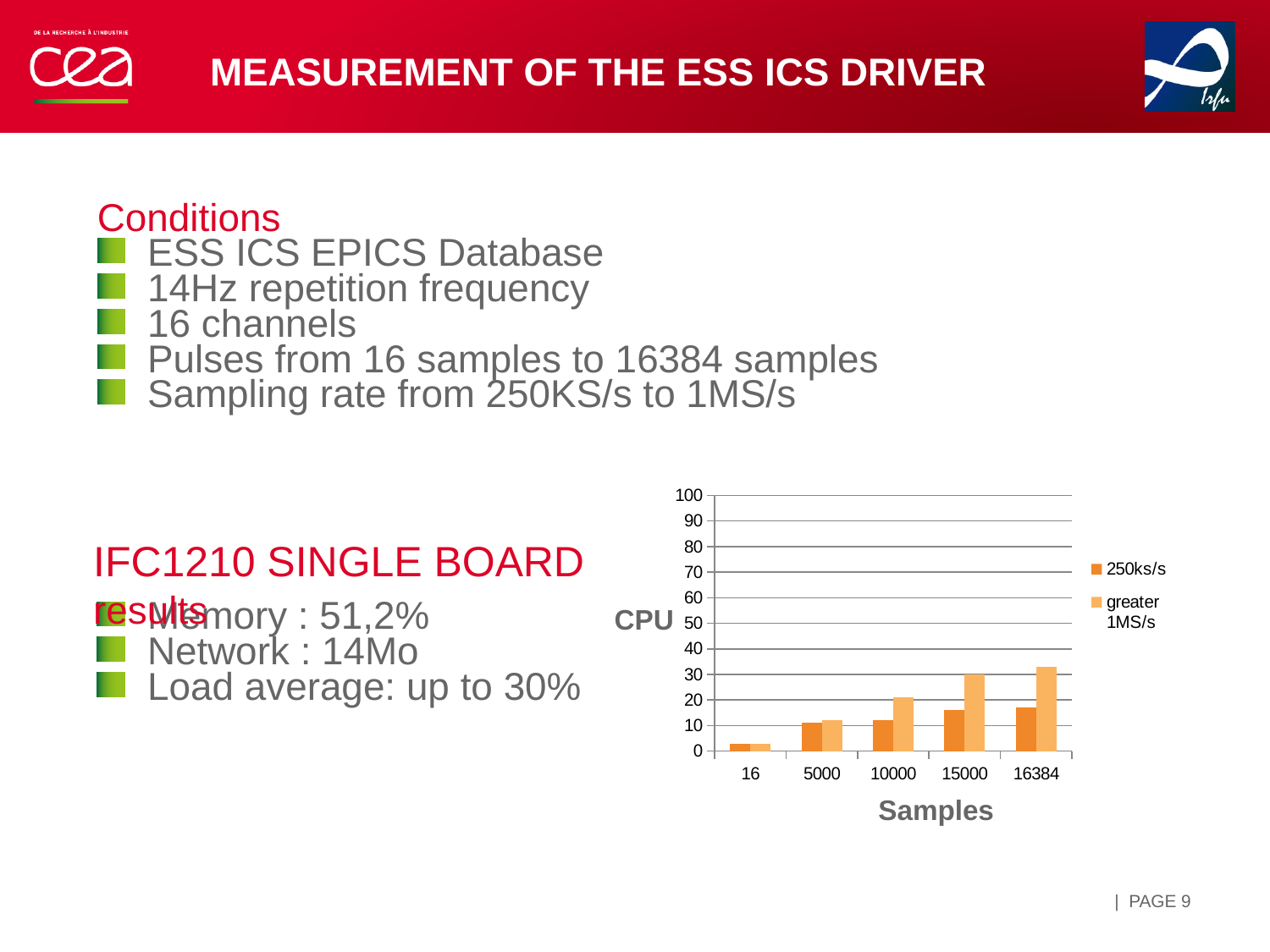
What kind of chart is shown on the slide? bar chart Is the 'greater 1MS/s' CPU value at 16 samples greater or less than 10? less Is the 'greater 1MS/s' CPU value at 16384 samples greater or less than 20? greater For which sample size is the '250ks/s' CPU value lowest? 16 At 15000 samples, which series has the larger CPU value, '250ks/s' or 'greater 1MS/s'? greater 1MS/s Is the '250ks/s' CPU value at 16384 samples greater or less than 20? less For which sample size is the 'greater 1MS/s' CPU value highest? 16384 Do the 'greater 1MS/s' CPU values rise or fall as the number of samples increases along the x axis? rise How many sample-size categories are shown on the x axis of the chart? 5 How many series does the chart legend list? 2 What label is shown on the vertical axis of the chart? CPU What is the title of the x axis of the chart? Samples